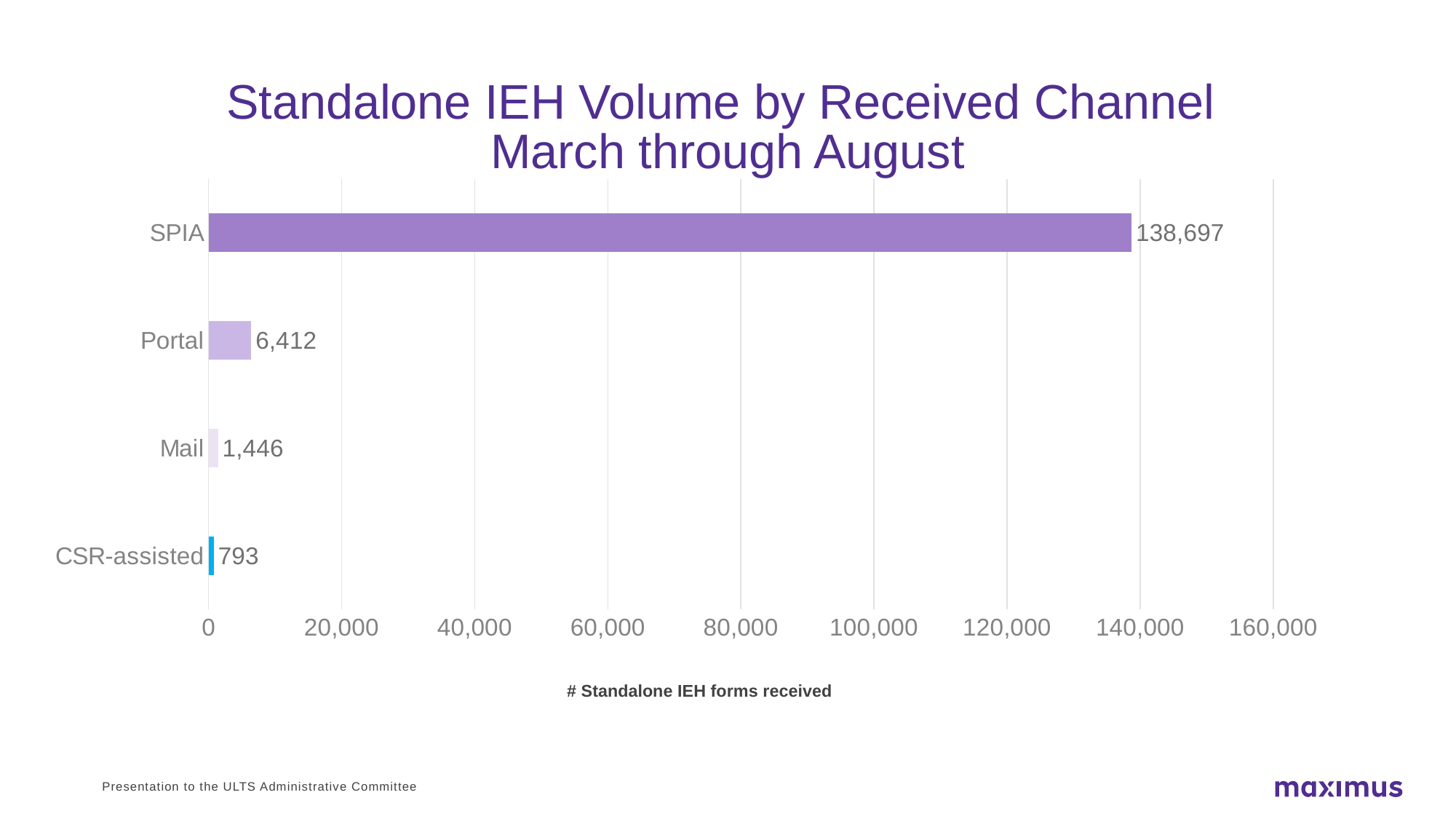
What is the difference between the SPIA and Portal values? 132,285 Is the value for SPIA greater or less than 120,000? greater Which channel has the highest volume? SPIA Which channel has the lowest volume? CSR-assisted What is the value for CSR-assisted? 793 What kind of chart is shown on the slide? Bar chart How many channels are shown on the chart? 4 What is the difference between the Mail and CSR-assisted values? 653 What is the value for Portal? 6,412 What is the value for SPIA? 138,697 What is the value for Mail? 1,446 Which is larger, the value for Portal or the value for Mail? Portal